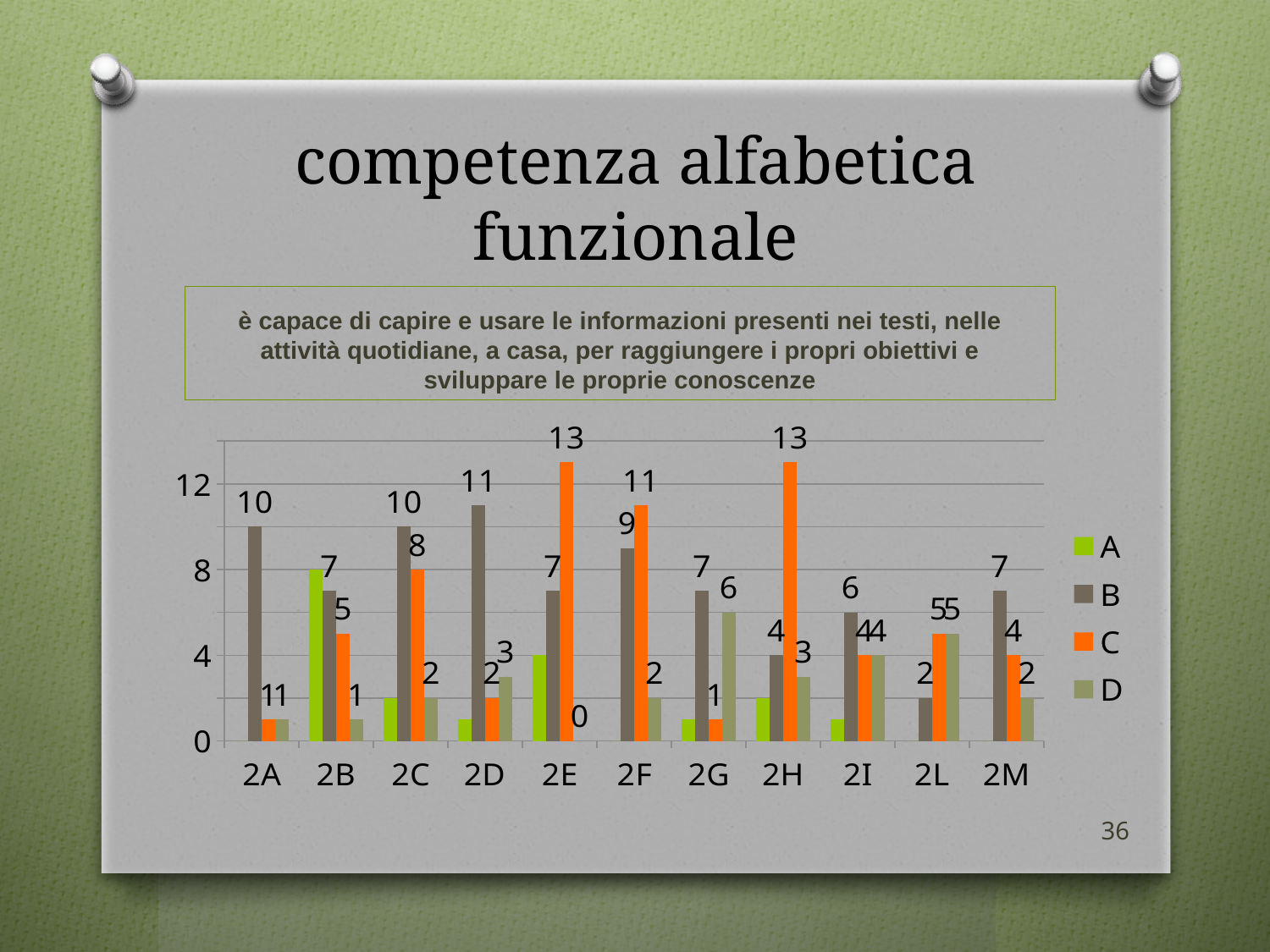
What is the value of series B for category 2A? 10 What is the value of series C for category 2E? 13 Which category has the lowest value for series D? 2E What is the value of series B for category 2D? 11 How many series does the legend list? 4 For category 2E, what is the difference between the values of series C and series B? 6 What kind of chart is shown on the slide? bar chart What is the value of series D for category 2G? 6 For category 2F, which is larger: series B or series C? C Is the value of series A for category 2B greater or less than 4? greater Which category has the highest value for series B? 2D How many categories are shown on the x axis? 11